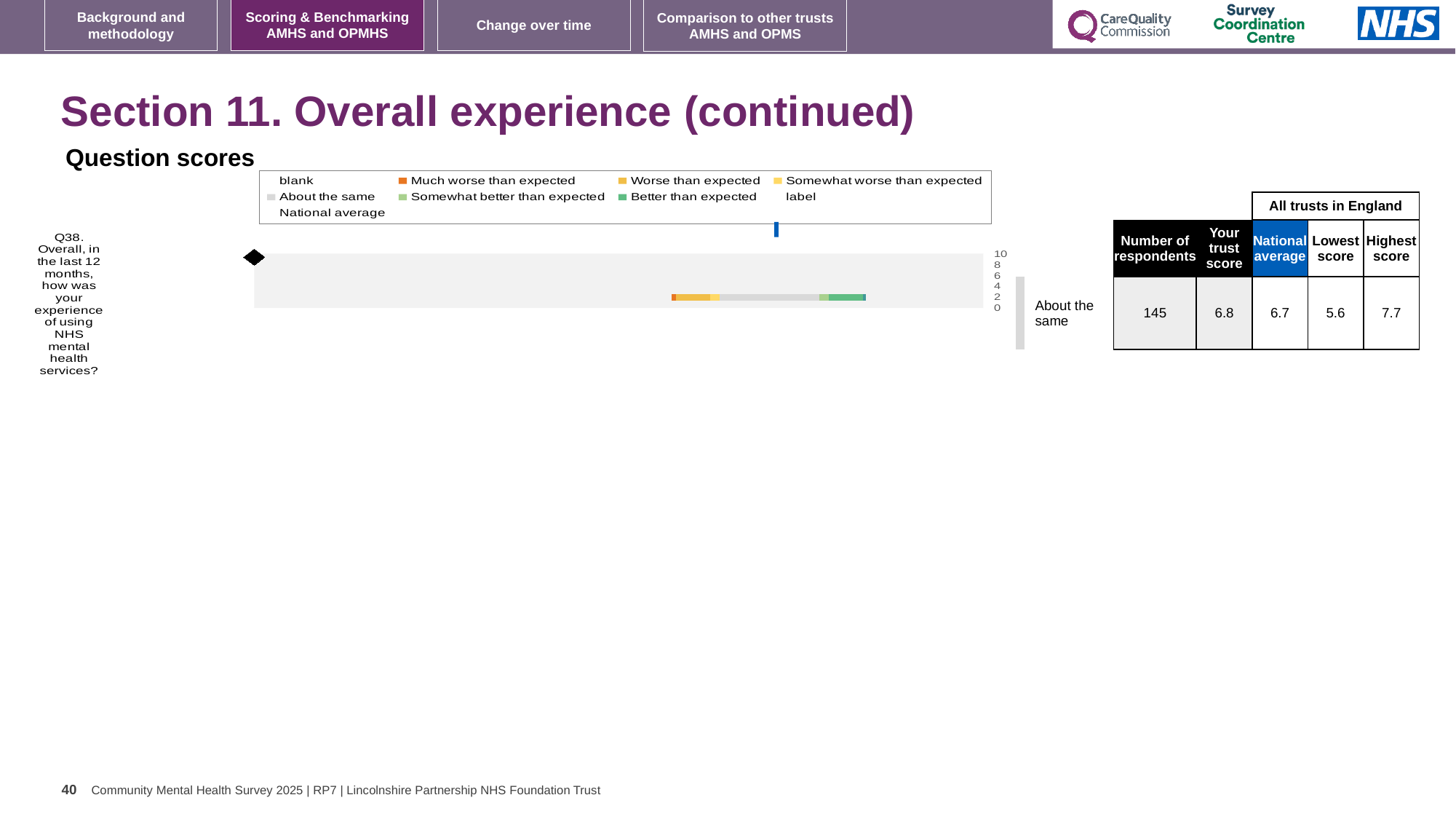
For Q38, what is the difference between the trust score and the National average? 0.1 What kind of chart is shown under 'Question scores'? bar chart In the table beside the chart, how many respondents answered Q38? 145 In the table beside the chart, what is the National average for Q38? 6.7 In the table beside the chart, what is the Lowest score among all trusts in England for Q38? 5.6 How many survey questions are plotted in the chart? 1 In the table beside the chart, what is the 'Your trust score' for Q38? 6.8 For Q38, which is larger: the trust score or the National average? Your trust score For Q38, what is the difference between the Highest score and the Lowest score among all trusts in England? 2.1 Which question number is plotted in the chart? Q38 In the table beside the chart, what is the Highest score among all trusts in England for Q38? 7.7 What is the highest tick value shown on the chart's score axis? 10